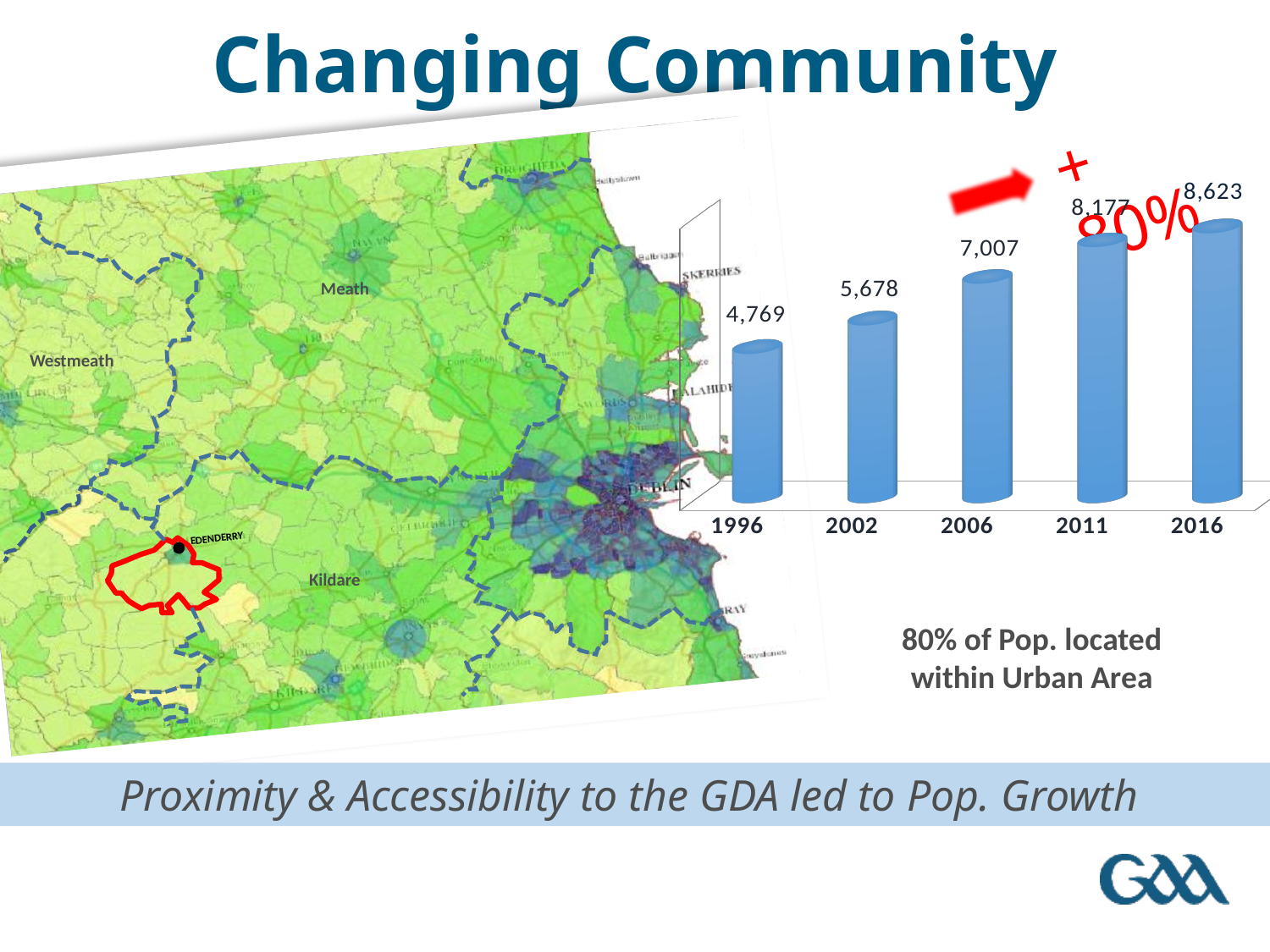
What is the difference between the 2016 value and the 2002 value? 2,945 What is the value shown for 1996? 4,769 What is the value shown for 2016? 8,623 What is the value shown for 2006? 7,007 How many years (bars) are shown in the bar chart? 5 Which year has the highest value in the bar chart? 2016 What type of chart is shown on the right of the slide? bar chart Which is larger, the value for 2002 or the value for 2006? 2006 What is the value shown for 2002? 5,678 Which year has the lowest value in the bar chart? 1996 Do the values rise or fall from 1996 to 2016? rise What is the difference between the 2006 value and the 1996 value? 2,238